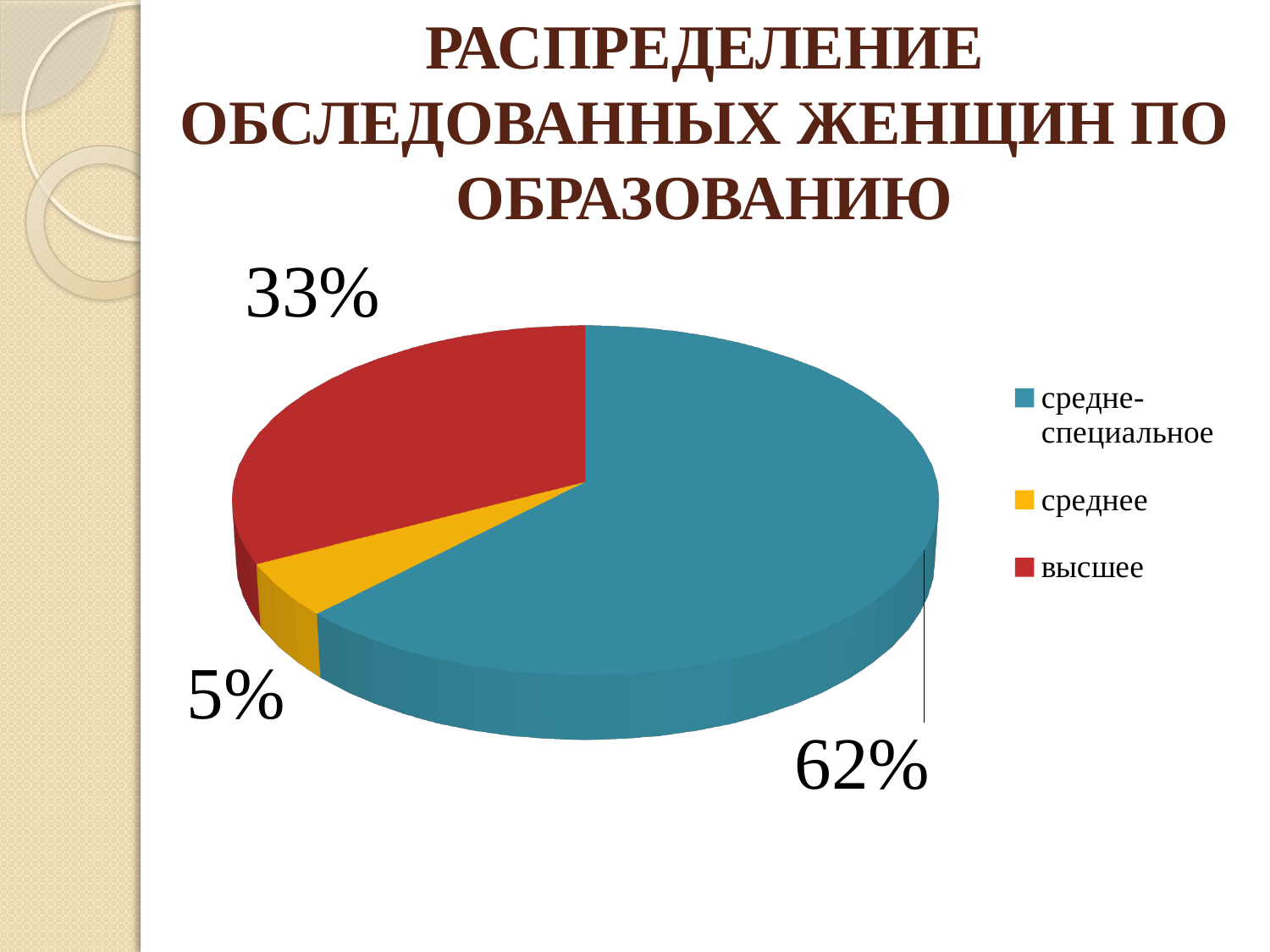
What is the difference in percentage points between the 'средне-специальное' and 'высшее' slices? 29 What is the difference in percentage points between the 'высшее' and 'среднее' slices? 28 What share of the pie does the 'высшее' slice represent? 33% What is the title of the chart on the slide? РАСПРЕДЕЛЕНИЕ ОБСЛЕДОВАННЫХ ЖЕНЩИН ПО ОБРАЗОВАНИЮ Which category has the smallest slice of the pie? среднее Which category has the largest slice of the pie? средне-специальное What colour is the 'высшее' slice? red Which slice is larger, 'высшее' or 'среднее'? высшее What share of the pie does the 'средне-специальное' slice represent? 62% How many categories are shown in the pie chart? 3 What kind of chart is shown on the slide? pie chart What share of the pie does the 'среднее' slice represent? 5%